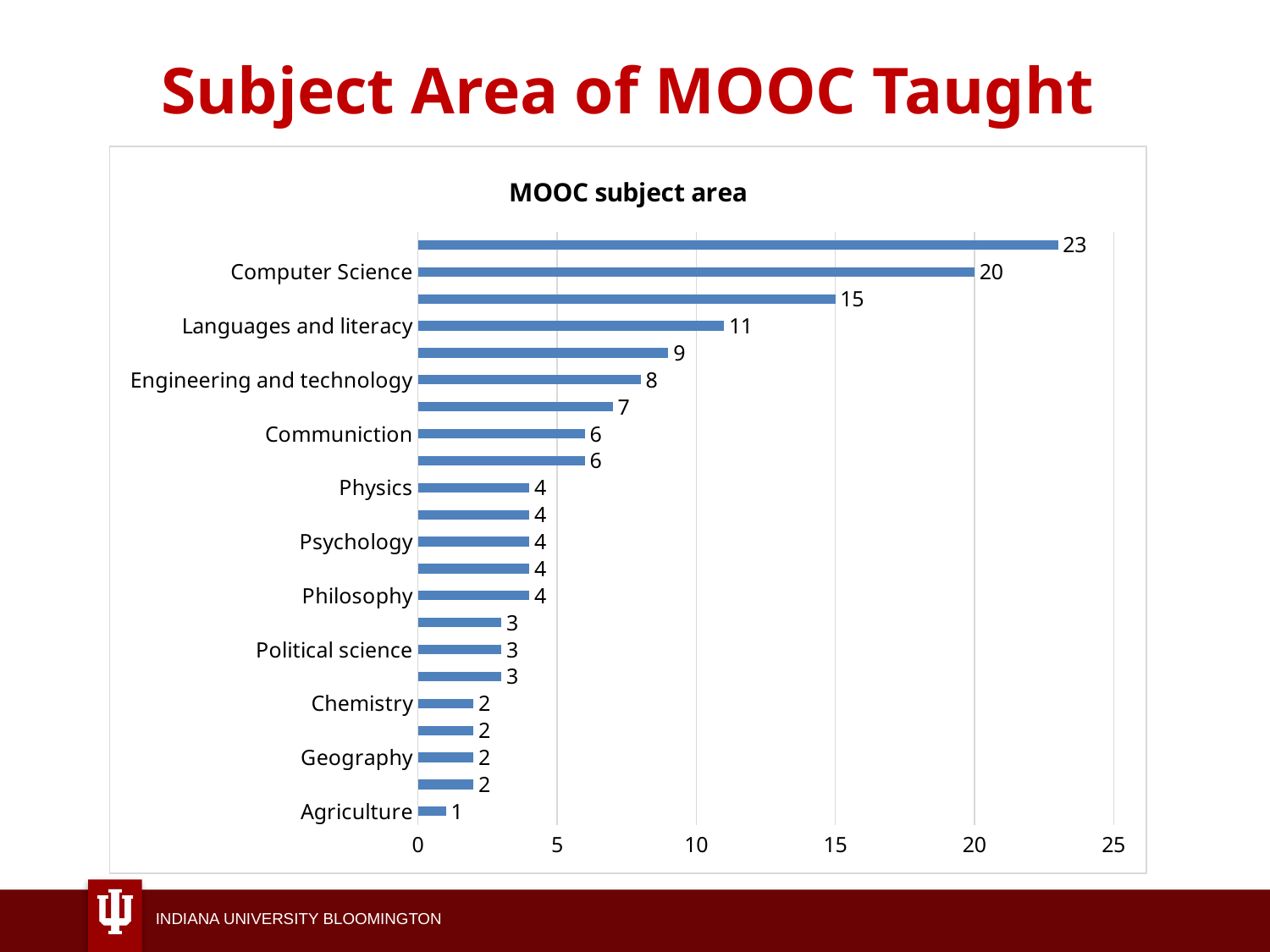
What is the value for Political science? 3 What kind of chart is shown on the slide? bar chart What is the value for Engineering and technology? 8 What is the value for Agriculture? 1 Which is larger, the value for Physics or the value for Geography? Physics Is the value for Computer Science greater or less than 15? greater How many bars are plotted in the chart? 22 What is the value for Computer Science? 20 What is the difference between the values for Computer Science and Languages and literacy? 9 Which labelled subject area has the lowest value? Agriculture What is the difference between the values for Engineering and technology and Chemistry? 6 What is the value for Languages and literacy? 11